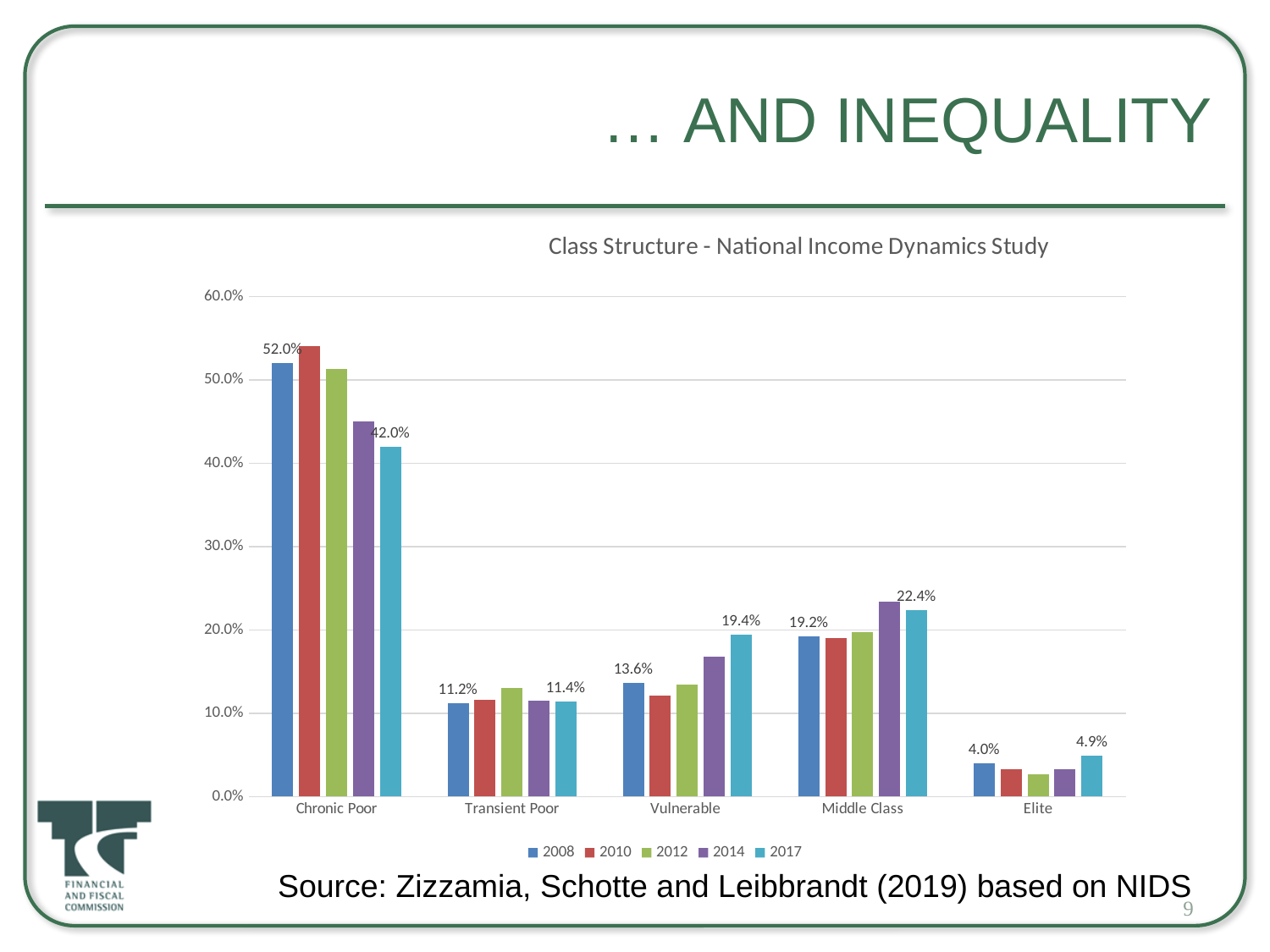
How many years does the legend list? 5 What is the value for Chronic Poor in 2008? 52.0% Is the value for Middle Class in 2014 greater or less than 20.0%? greater What is the title of the chart? Class Structure - National Income Dynamics Study By how much did the Chronic Poor share fall from 2008 to 2017? 10.0% What is the value for Elite in 2017? 4.9% Which is larger: the Vulnerable value in 2008 or in 2017? 2017 Which class has the lowest value in 2008? Elite What is the value for Middle Class in 2008? 19.2% What is the value for Chronic Poor in 2017? 42.0% Which class has the highest value in 2017? Chronic Poor What is the value for Vulnerable in 2017? 19.4%